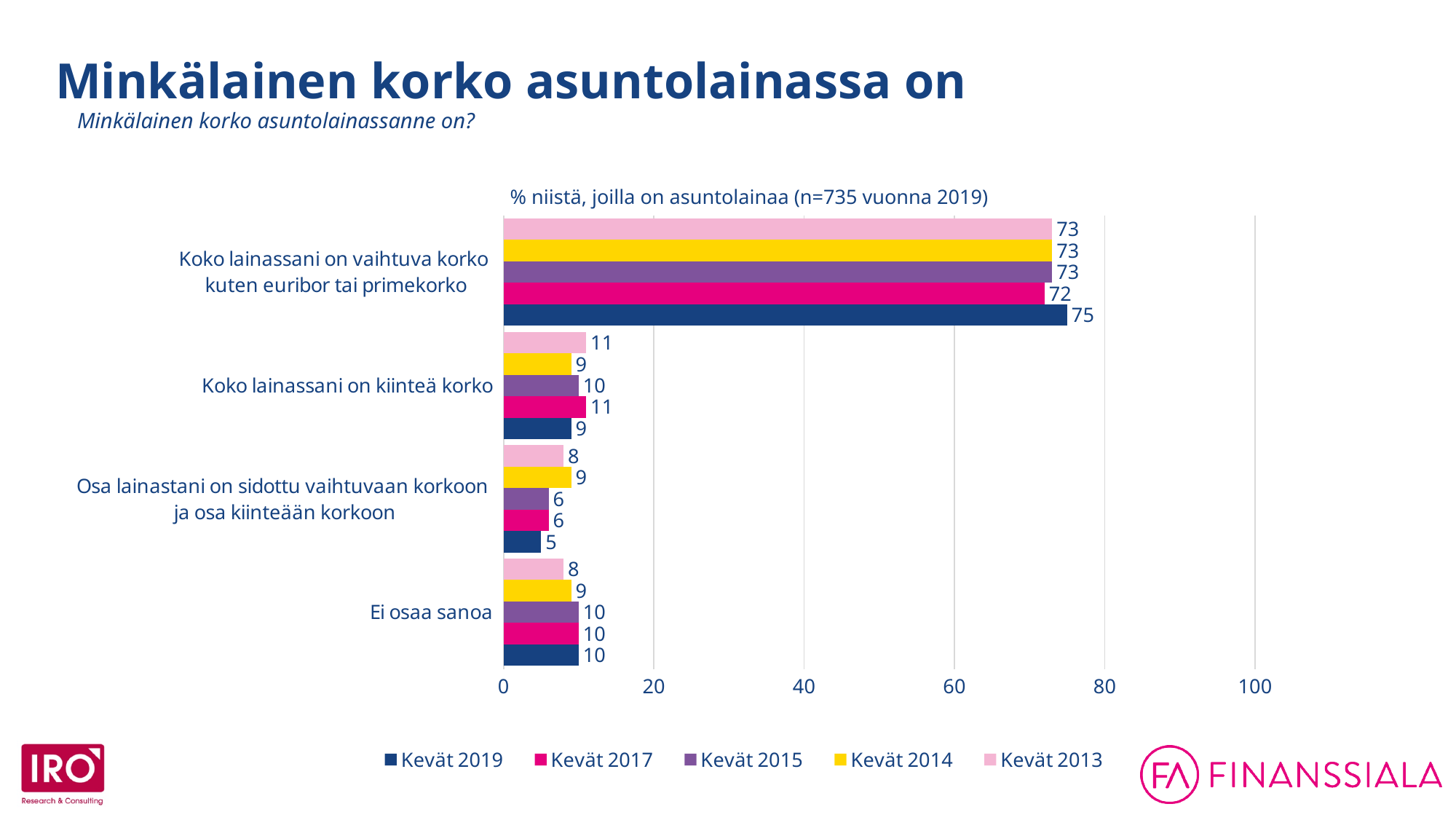
What is the difference between the Kevät 2019 and Kevät 2017 values for "Koko lainassani on vaihtuva korko kuten euribor tai primekorko"? 3 Which category has the lowest Kevät 2019 value? Osa lainastani on sidottu vaihtuvaan korkoon ja osa kiinteään korkoon Which category has the highest Kevät 2019 value? Koko lainassani on vaihtuva korko kuten euribor tai primekorko For "Osa lainastani on sidottu vaihtuvaan korkoon ja osa kiinteään korkoon", which is larger: the Kevät 2013 value or the Kevät 2019 value? Kevät 2013 What is the Kevät 2013 value for "Ei osaa sanoa"? 8 What is the Kevät 2019 value for "Koko lainassani on vaihtuva korko kuten euribor tai primekorko"? 75 Is the Kevät 2015 value for "Koko lainassani on vaihtuva korko kuten euribor tai primekorko" greater or less than 60? greater What is the Kevät 2014 value for "Osa lainastani on sidottu vaihtuvaan korkoon ja osa kiinteään korkoon"? 9 What kind of chart is shown on the slide? bar chart How many categories are shown on the chart? 4 How many series does the legend list? 5 What is the Kevät 2017 value for "Koko lainassani on kiinteä korko"? 11